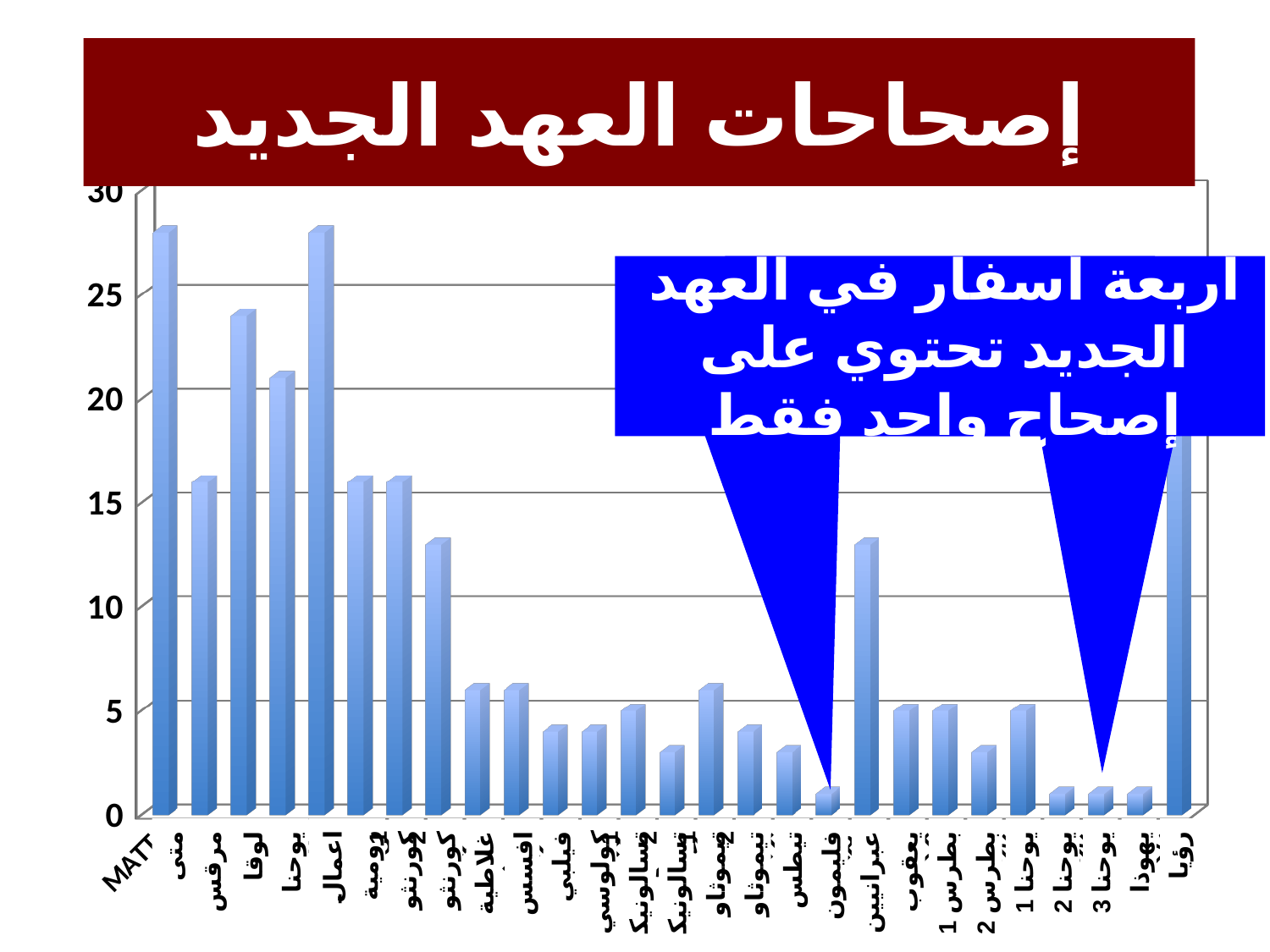
Is the value for 2تسالونيك greater or less than 5? less Is the value for فليمون greater or less than 5? less What is the highest value shown on the vertical axis of the chart? 30 What kind of chart is shown on the slide? bar chart Is the value for عبرانيين greater or less than 10? greater What is the title of the chart on the slide? إصحاحات العهد الجديد Which has the larger value, لوقا or مرقس? لوقا Which has the larger value, رؤيا or عبرانيين? رؤيا Which has the larger value, عبرانيين or يعقوب? عبرانيين